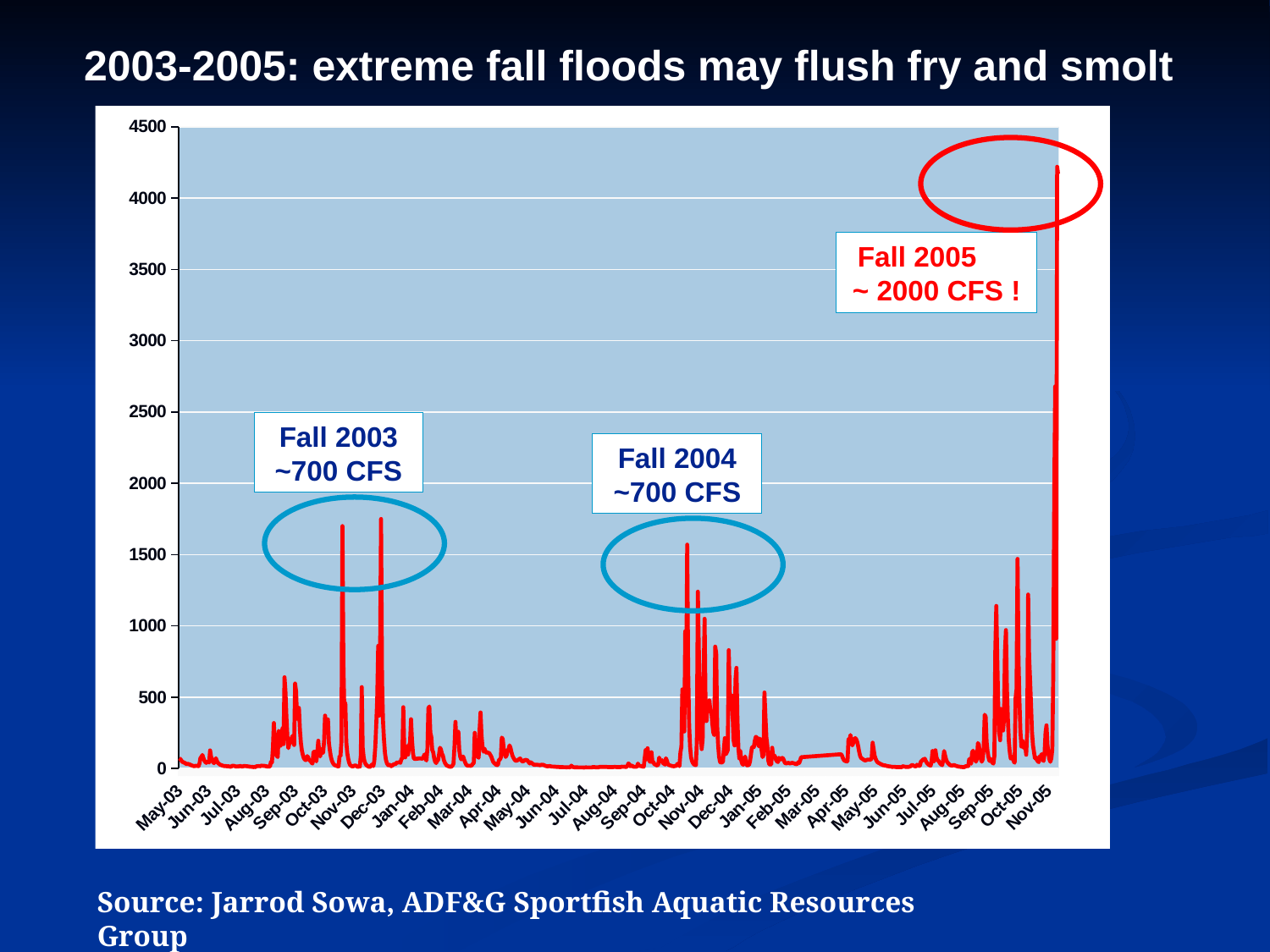
What flow value does the annotation give for Fall 2005? ~ 2000 CFS ! Is the highest Fall 2004 peak (around Oct-04) greater or less than 1000? greater In which month label does the line reach its highest peak? Nov-05 How many month labels are shown on the x axis? 31 Are the values around Mar-05 greater or less than 500? less What is the title of the slide containing the chart? 2003-2005: extreme fall floods may flush fry and smolt What kind of chart is shown on the slide? line chart Are the values around Jun-04 greater or less than 500? less What is the highest value shown on the y axis? 4500 Which peak is larger, the one in Nov-03 or the one in Nov-05? Nov-05